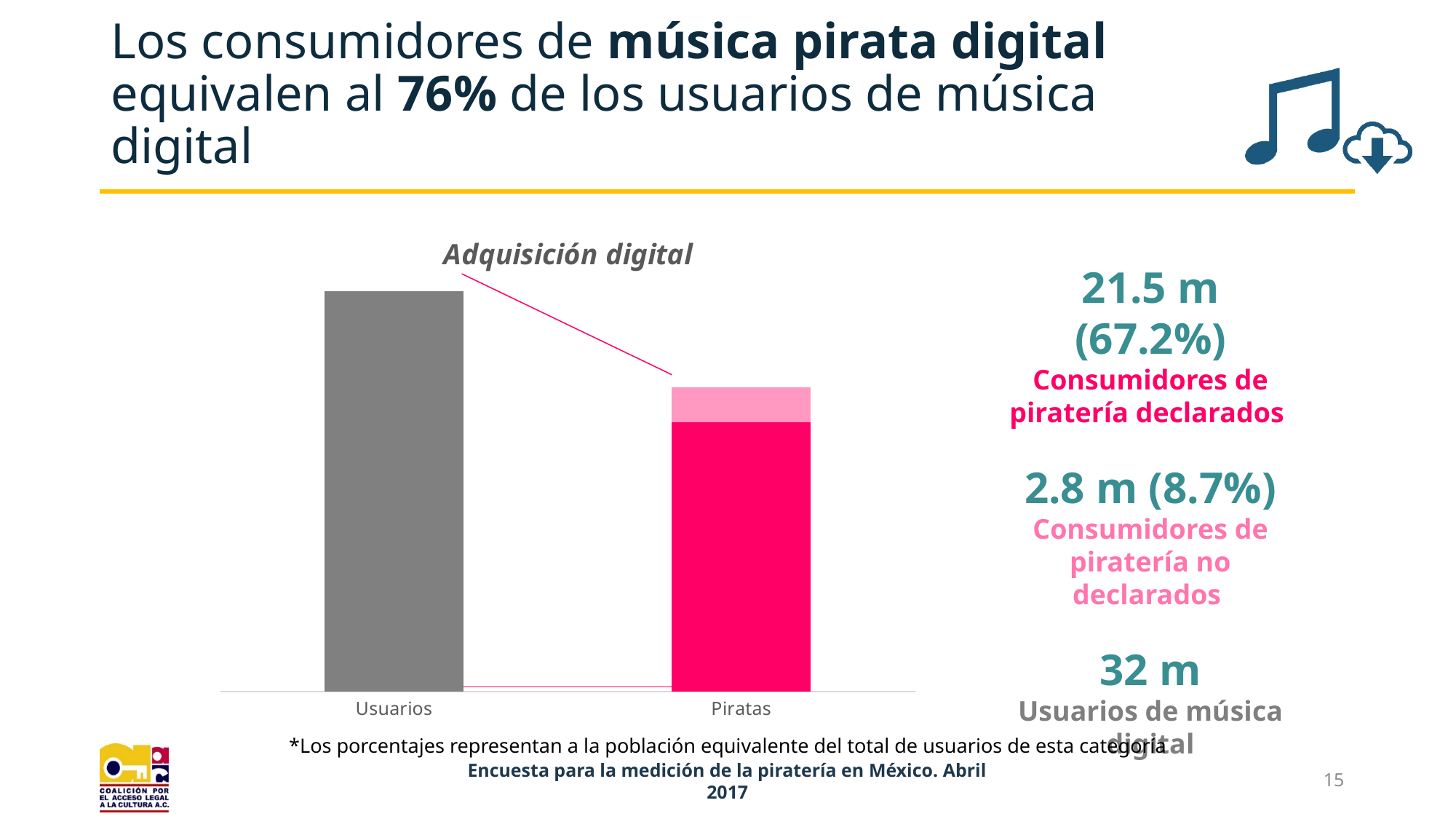
What is the title of the chart? Adquisición digital What is the difference in millions between the digital music users (32 m) and the declared piracy consumers (21.5 m)? 10.5 m What is the total of the stacked Piratas bar, adding declared and non-declared piracy consumers in millions? 24.3 m What percentage of digital music users do the declared piracy consumers represent? 67.2% What percentage of digital music users do the non-declared piracy consumers represent? 8.7% According to the slide, how many non-declared piracy consumers (Consumidores de piratería no declarados) are there? 2.8 m How many categories are shown on the x axis of the chart? 2 Which category has the lowest bar in the chart? Piratas According to the slide, how many users of digital music (Usuarios de música digital) are there? 32 m According to the slide, how many declared piracy consumers (Consumidores de piratería declarados) are there? 21.5 m What kind of chart is shown on the slide? bar chart Which category has the taller bar, Usuarios or Piratas? Usuarios